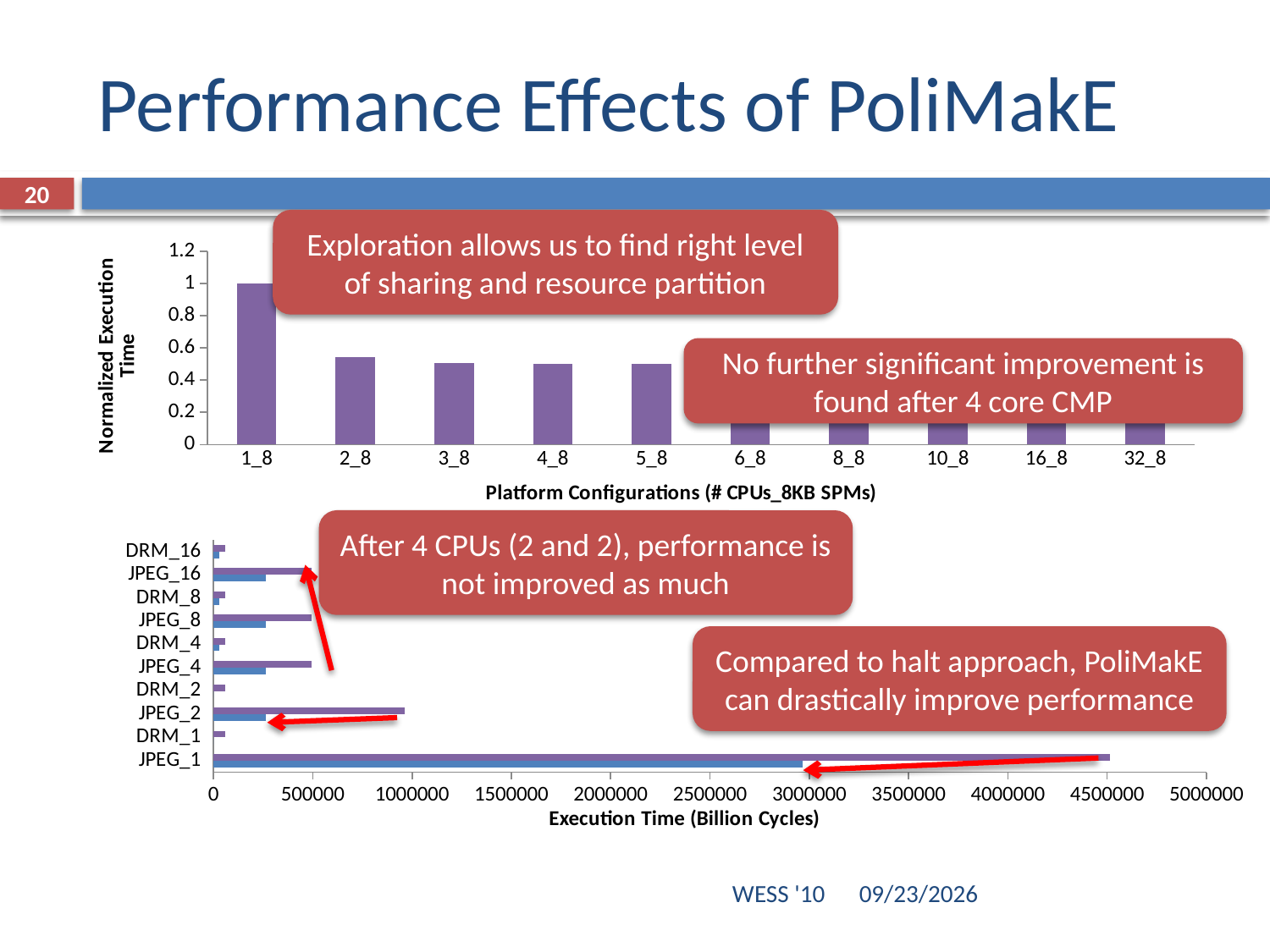
What kind of chart is the bottom chart (Execution Time)? bar chart In the top chart, what is the normalized execution time for configuration 1_8? 1 In the top chart, do the values generally rise or fall from 1_8 to 32_8? fall What is the x-axis title of the top chart? Platform Configurations (# CPUs_8KB SPMs) In the top chart, which platform configuration has the highest normalized execution time? 1_8 How many platform configurations are shown on the x axis of the top chart? 10 In the top chart, which has the larger normalized execution time, 1_8 or 2_8? 1_8 In the bottom chart, is the longer (purple) bar for JPEG_1 greater or less than 4000000? greater How many categories are listed on the vertical axis of the bottom chart? 10 In the top chart, is the value for 3_8 greater or less than 0.4? greater What kind of chart is the top chart (Normalized Execution Time)? bar chart In the top chart, is the value for 2_8 greater or less than 0.8? less